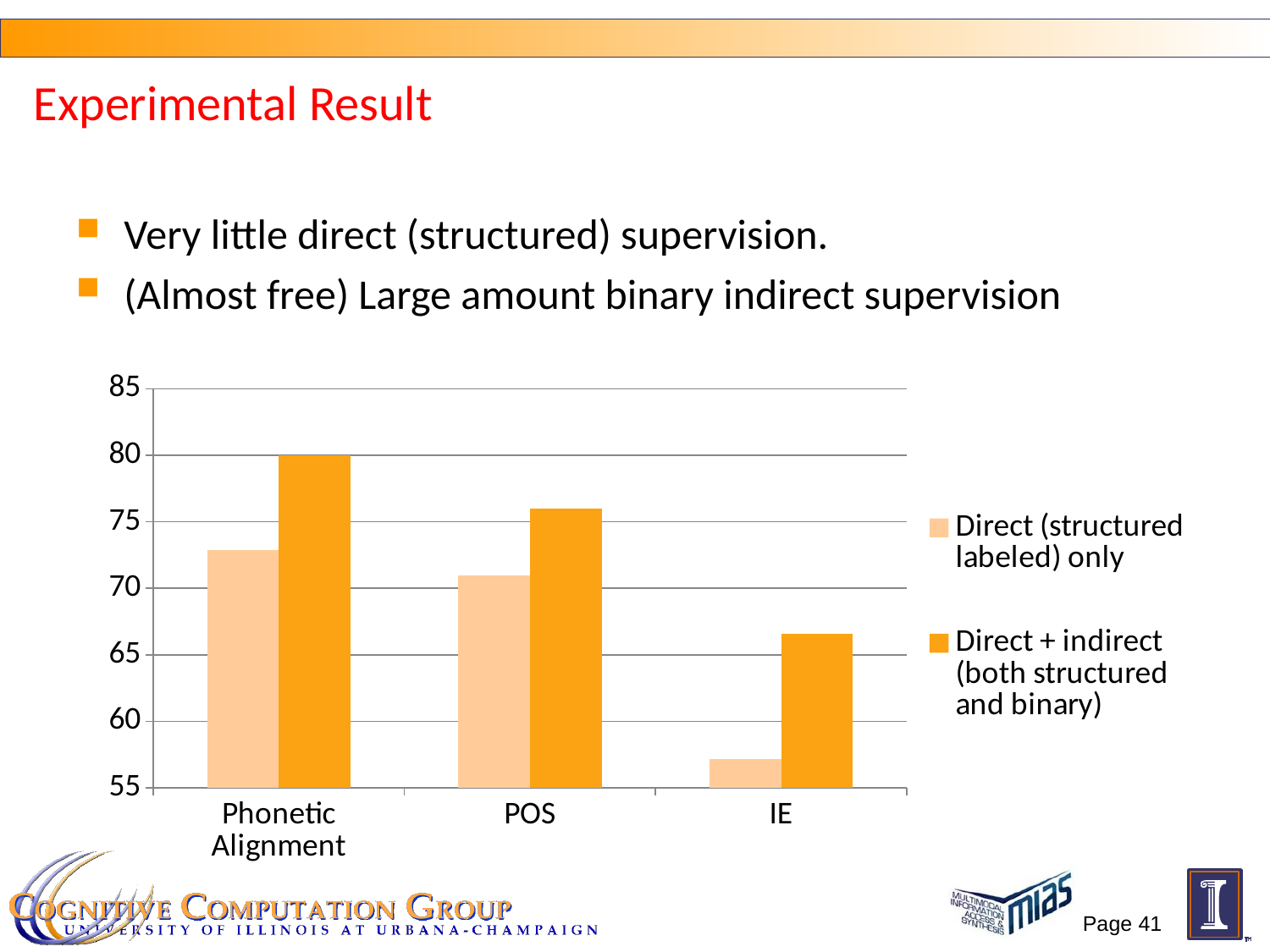
What kind of chart is shown on the slide? bar chart Is the 'Direct + indirect (both structured and binary)' value for IE greater or less than 70? less For POS, which series has the larger value: 'Direct (structured labeled) only' or 'Direct + indirect (both structured and binary)'? Direct + indirect (both structured and binary) Is the 'Direct (structured labeled) only' value for Phonetic Alignment greater or less than 70? greater Which category has the lowest value for the 'Direct (structured labeled) only' series? IE How many series does the chart legend list? 2 What is the lowest value shown on the chart's vertical axis? 55 Is the 'Direct + indirect (both structured and binary)' value for POS greater or less than 75? greater How many categories are shown on the x axis of the chart? 3 Do the values for the 'Direct (structured labeled) only' series rise or fall from Phonetic Alignment to IE along the x axis? fall Which category has the highest value for the 'Direct + indirect (both structured and binary)' series? Phonetic Alignment